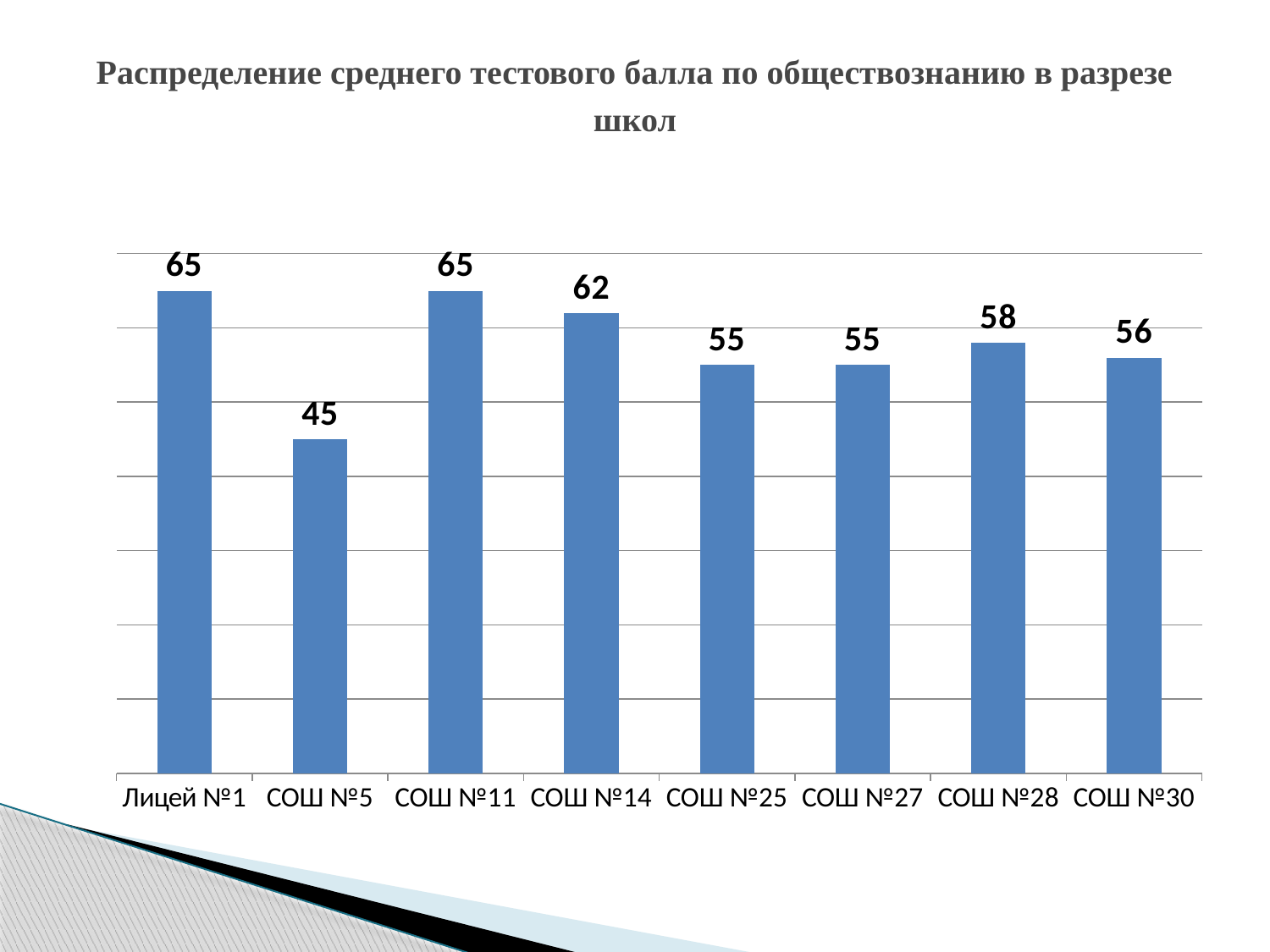
What is the difference between the scores of СОШ №14 and СОШ №25? 7 What is the difference between the scores of Лицей №1 and СОШ №5? 20 What is the average test score for СОШ №30? 56 What is the title of the chart? Распределение среднего тестового балла по обществознанию в разрезе школ Which school has the lowest average test score? СОШ №5 What is the average test score for СОШ №28? 58 Which has a higher average test score, СОШ №28 or СОШ №27? СОШ №28 What is the highest average test score shown on the chart? 65 What type of chart is shown on the slide? Bar chart What is the average test score for СОШ №14? 62 What is the average test score for СОШ №5? 45 How many schools are shown on the chart? 8